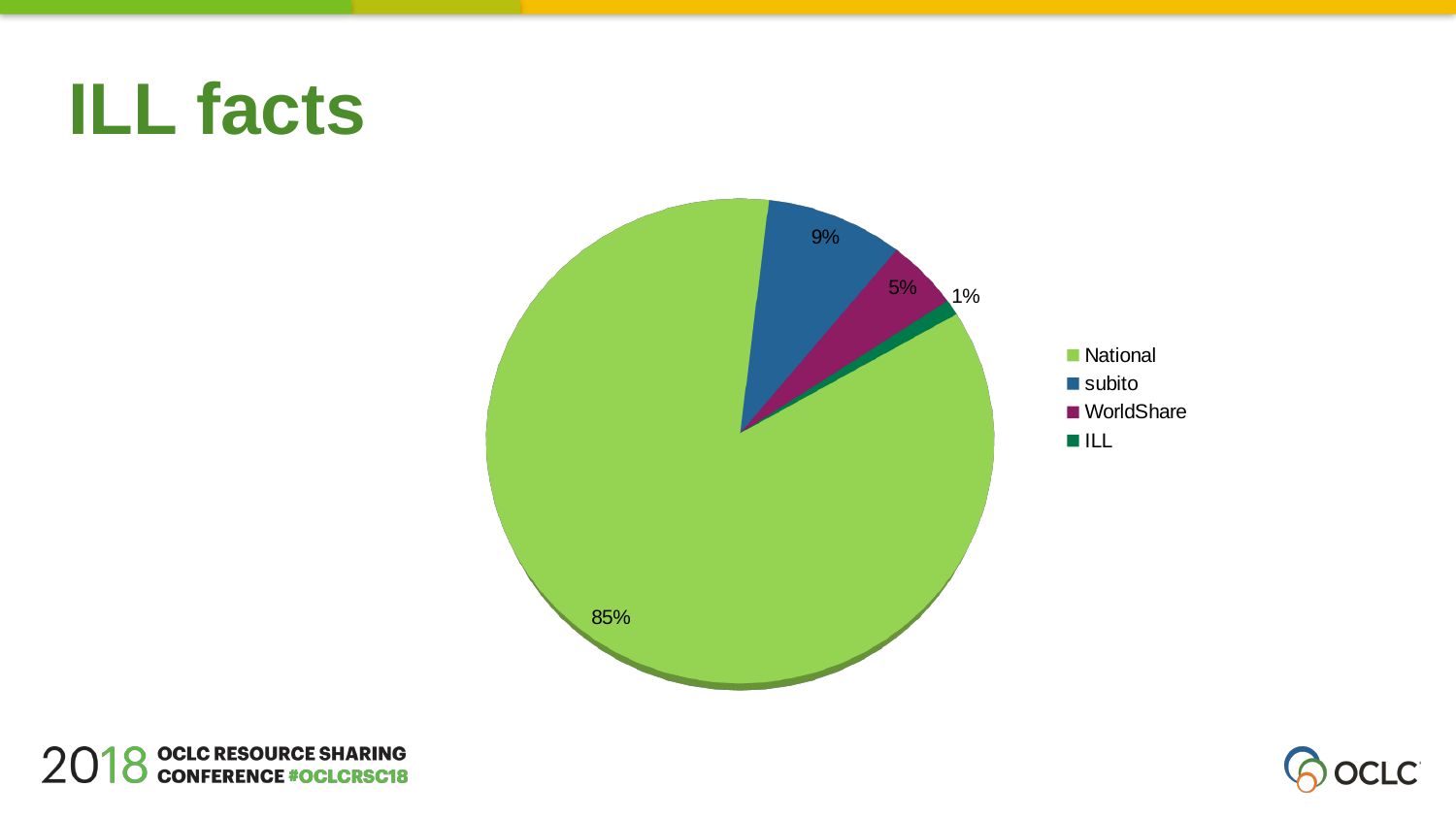
What colour is the National slice in the pie chart? green Which is larger, the subito slice or the WorldShare slice? subito What is the difference in percentage points between the WorldShare and ILL slices? 4 What share of the pie does WorldShare have? 5% How many categories does the pie chart show? 4 What share of the pie does subito have? 9% What share of the pie does ILL have? 1% What is the difference in percentage points between the National and subito slices? 76 Which category has the largest slice of the pie? National Which category has the smallest slice of the pie? ILL What share of the pie does National have? 85% What kind of chart is shown on the slide? pie chart